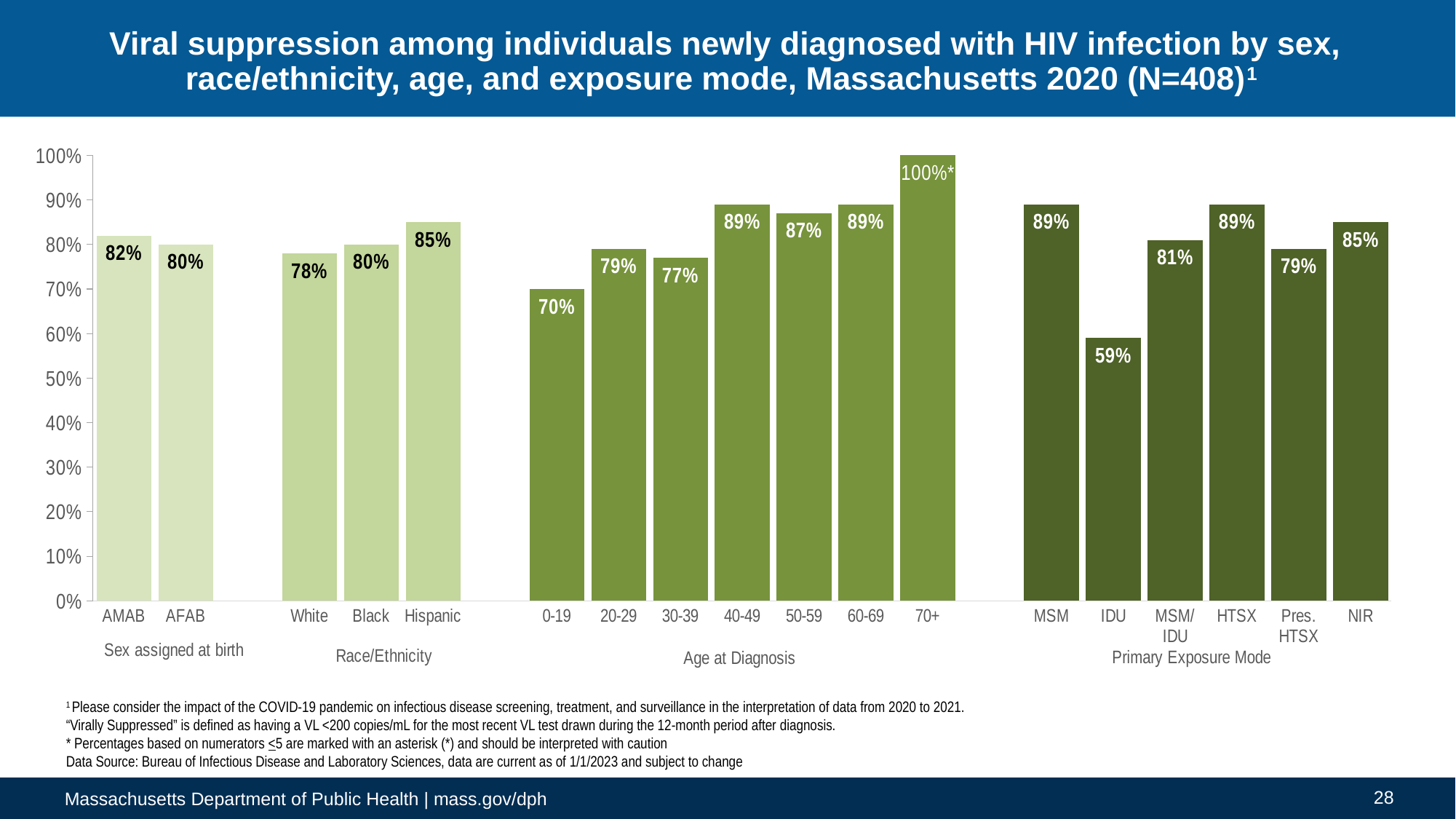
How many age at diagnosis categories are shown? 7 Which primary exposure mode has the lowest viral suppression percentage? IDU What is the difference in viral suppression percentage between MSM and IDU? 30% Which has a higher viral suppression percentage, AMAB or AFAB? AMAB What is the viral suppression percentage for the Hispanic group? 85% What is the difference in viral suppression percentage between Hispanic and White? 7% What is the viral suppression percentage for the 0-19 age group? 70% Which age at diagnosis group has the highest viral suppression percentage? 70+ What is the viral suppression percentage for IDU? 59% What is the viral suppression percentage for AMAB? 82% What kind of chart is shown on the slide? Bar chart Which bar is marked with an asterisk indicating a numerator of 5 or fewer? 70+